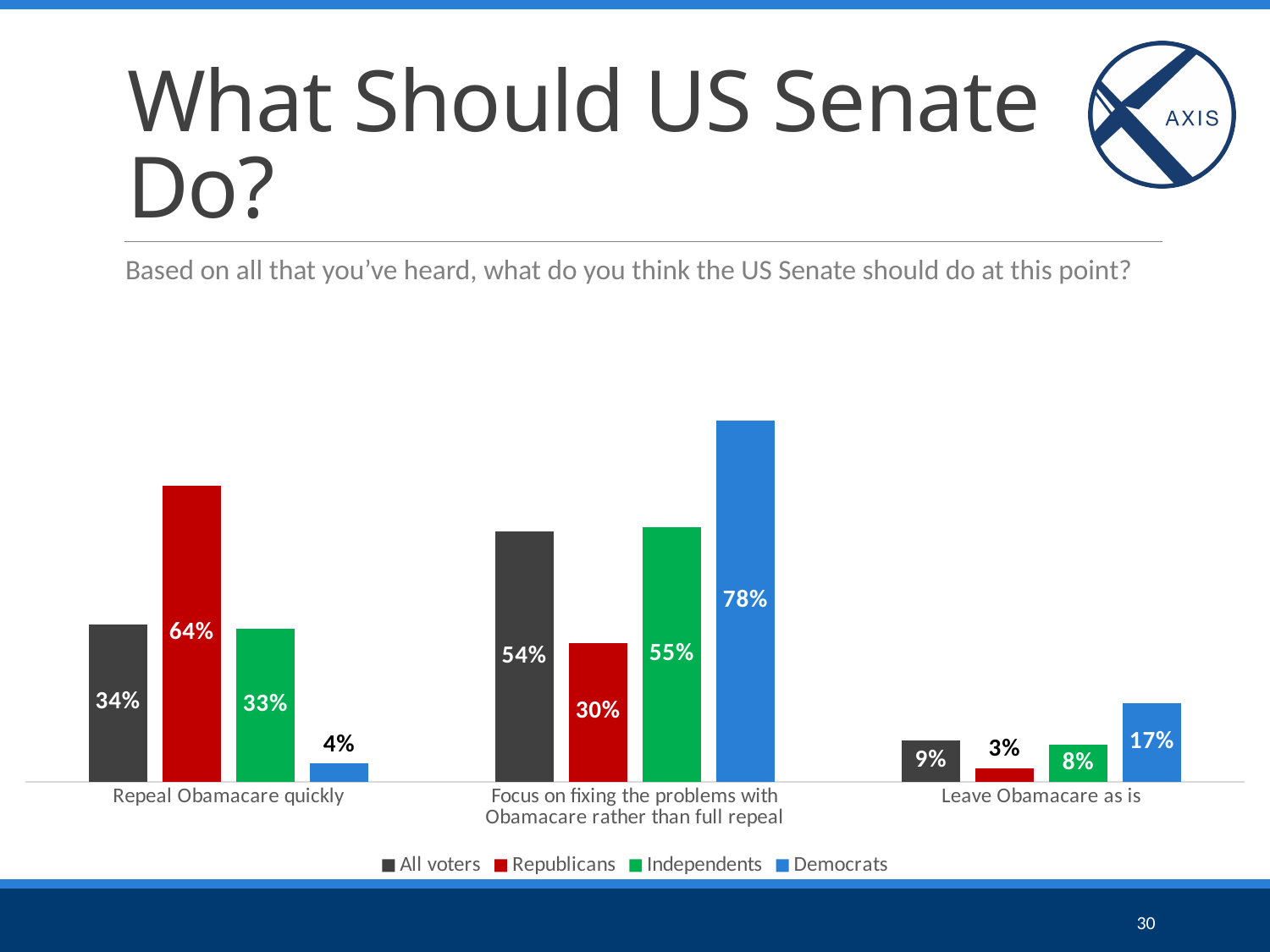
What percentage of Independents say the Senate should repeal Obamacare quickly? 33% How many response categories are shown on the x axis? 3 What percentage of Democrats say the Senate should focus on fixing the problems with Obamacare rather than full repeal? 78% Which group has the highest value for 'Repeal Obamacare quickly'? Republicans Which is larger: the Independents value for 'Repeal Obamacare quickly' or the Independents value for 'Focus on fixing the problems with Obamacare rather than full repeal'? Focus on fixing the problems with Obamacare rather than full repeal Which colour represents Democrats in the chart? Blue What percentage of Republicans say the Senate should repeal Obamacare quickly? 64% How many series does the legend list? 4 What percentage of all voters say the Senate should leave Obamacare as is? 9% What is the difference between the Democrats and Republicans values for 'Focus on fixing the problems with Obamacare rather than full repeal'? 48% What kind of chart is shown on the slide? Bar chart Which group has the lowest value for 'Leave Obamacare as is'? Republicans